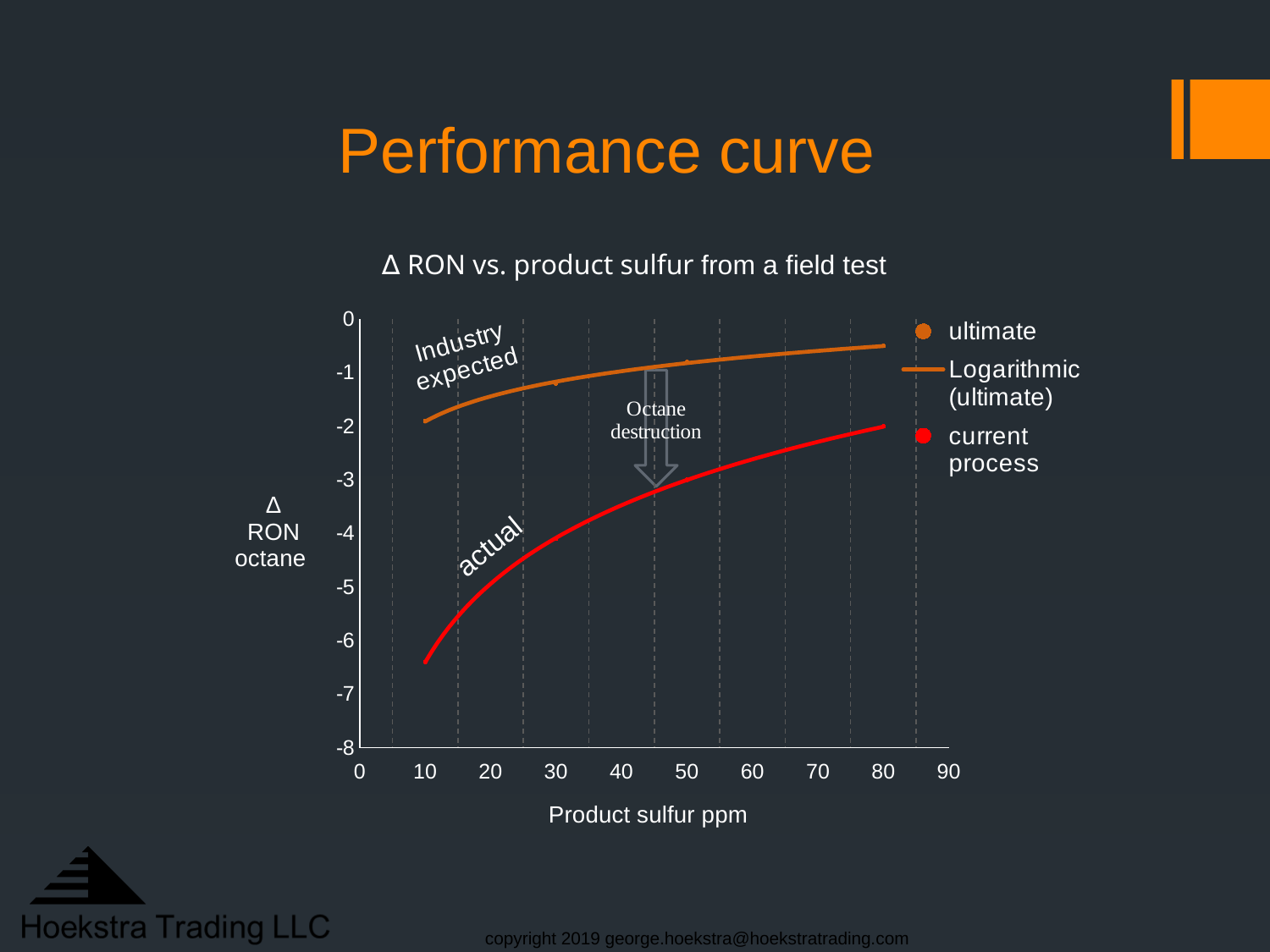
What kind of chart is shown on the slide? line chart How many tick labels are shown on the x axis? 10 Is the value of the 'Industry expected' curve at 80 ppm product sulfur greater or less than -1? greater As product sulfur increases along the x axis, does the 'actual' curve rise or fall? rise What is the label of the x axis? Product sulfur ppm Is the value of the 'actual' curve at 10 ppm product sulfur greater or less than -6? less At 50 ppm product sulfur, which curve has the higher Δ RON value, 'Industry expected' or 'actual'? Industry expected What is the title of the chart? Δ RON vs. product sulfur from a field test How many entries does the chart legend list? 3 As product sulfur increases along the x axis, does the 'Industry expected' curve rise or fall? rise Is the value of the 'Industry expected' curve at 50 ppm product sulfur greater or less than -1? greater